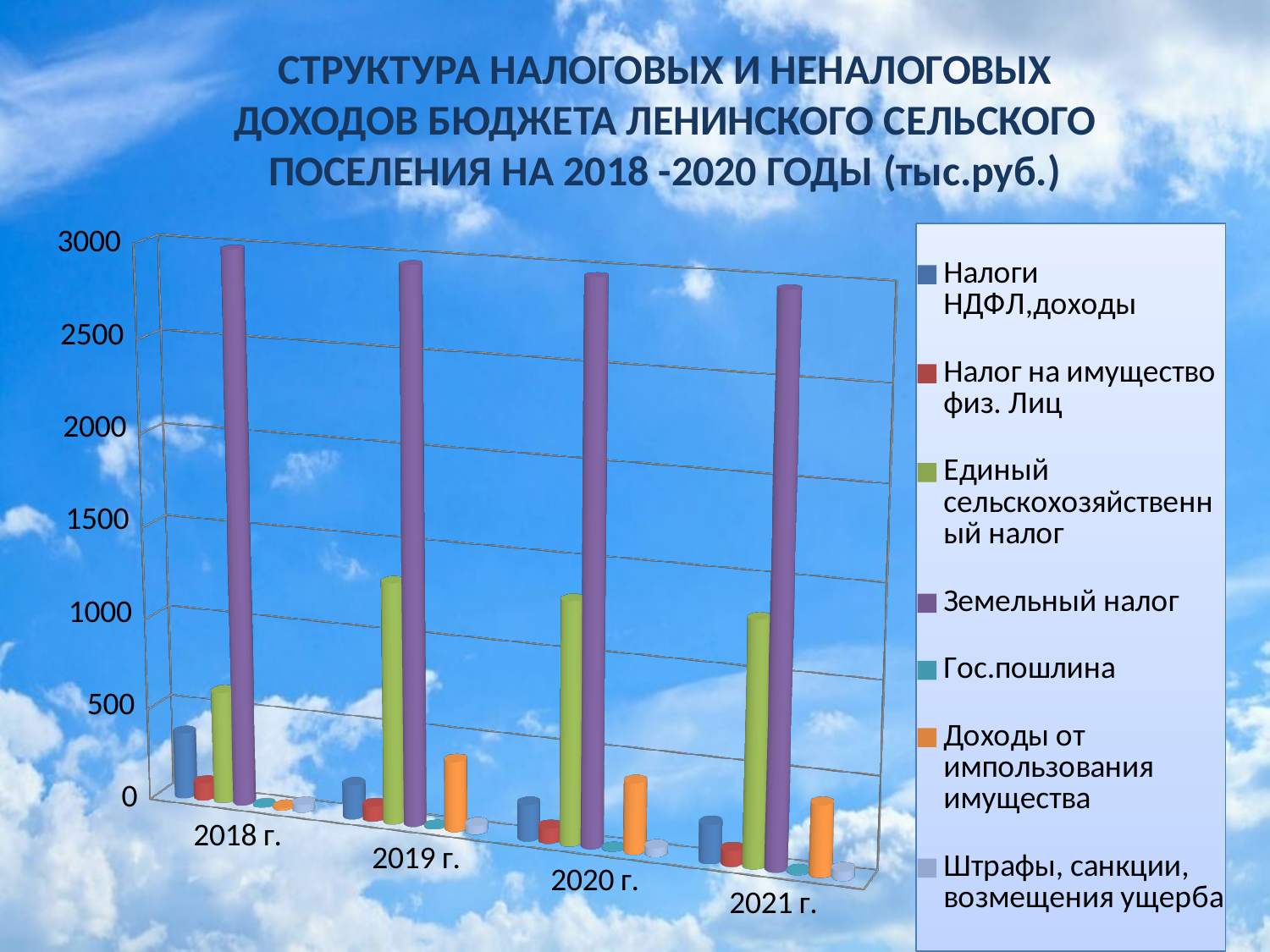
Is the value for Доходы от импользования имущества in 2021 г. greater or less than 500? less Which is larger: Земельный налог in 2018 г. or Земельный налог in 2021 г.? 2018 г. Does the value for Земельный налог rise or fall from 2018 г. to 2021 г.? fall Which series has the highest value in 2018 г.? Земельный налог Is the value for Земельный налог in 2018 г. greater or less than 2500? greater What kind of chart is shown on the slide? bar chart Is the value for Единый сельскохозяйственный налог in 2018 г. greater or less than 1000? less How many series does the legend list? 7 How many years (categories) are shown on the x axis of the chart? 4 What colour represents Земельный налог in the legend? purple Which series has the highest value in 2021 г.? Земельный налог